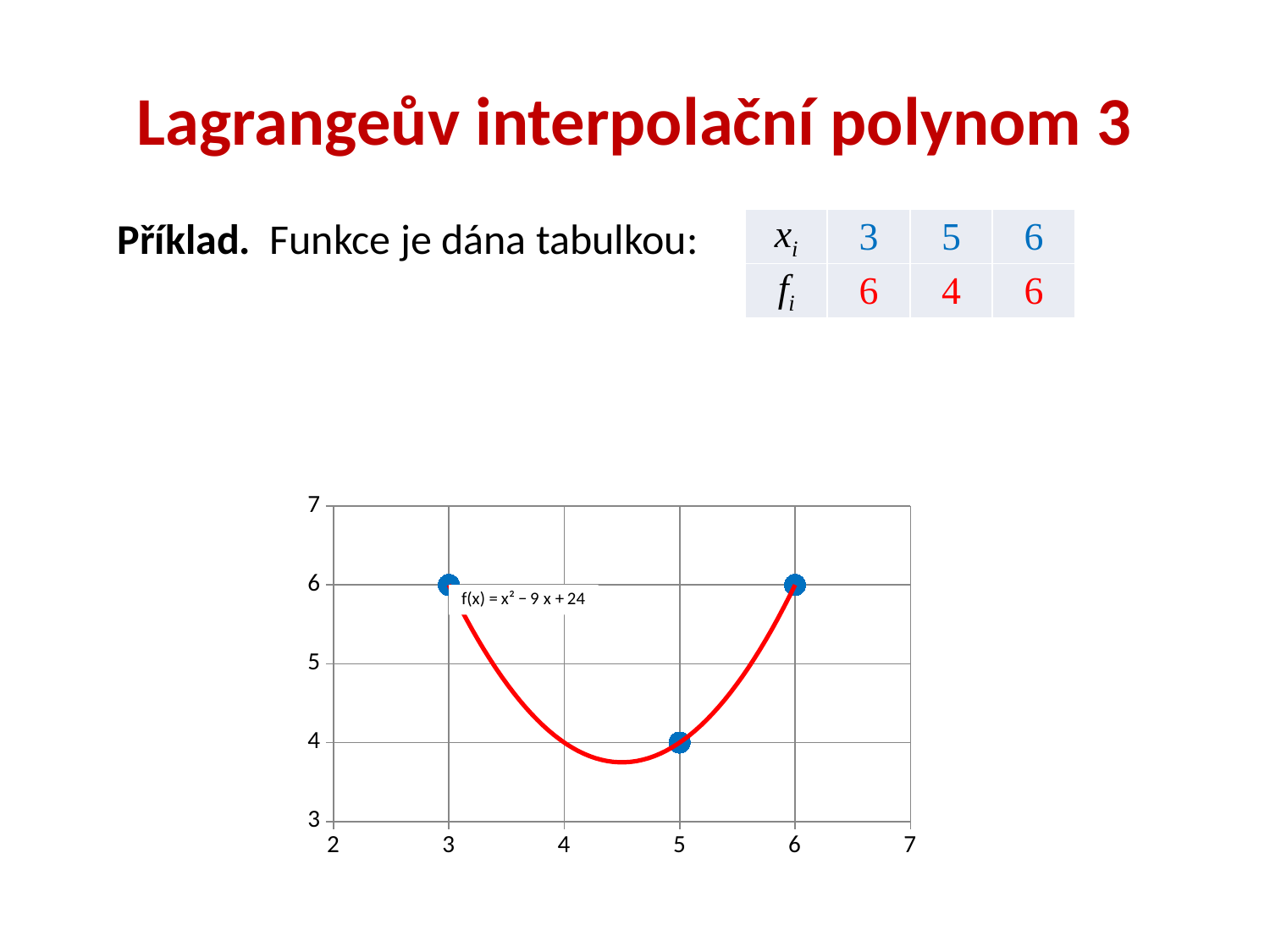
What is the difference between the y value at x = 3 and the y value at x = 5? 2 What colour is the fitted curve on the chart? red What kind of chart is shown on the slide? scatter chart Which plotted point has the larger y value, the one at x = 5 or the one at x = 6? x = 6 How many data points are plotted on the chart? 3 What is the y value of the plotted point at x = 3? 6 What is the y value of the plotted point at x = 6? 6 What is the y value of the plotted point at x = 5? 4 Is the y value of the plotted point at x = 5 greater or less than 5? less At which x value does the plotted point have the lowest y value? 5 Do the plotted y values rise or fall from x = 5 to x = 6? rise What equation is printed on the chart for the fitted curve? f(x) = x² − 9 x + 24